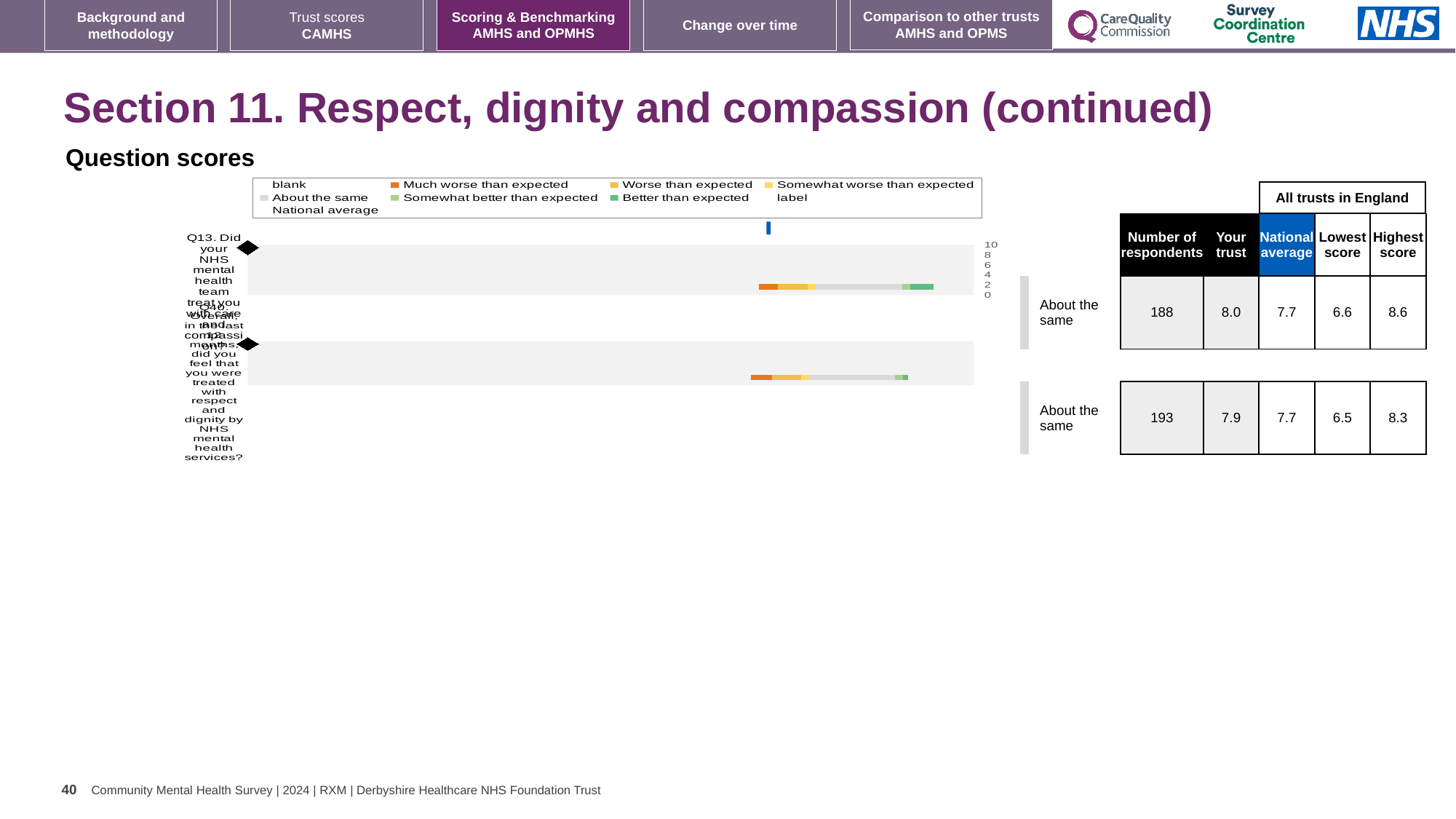
What is the difference between the highest score and the lowest score for Q10 in the table beside the chart? 1.8 In the table beside the chart, what is the lowest score across all trusts in England for Q10? 6.5 In the table beside the chart, what is the 'Your trust' score for Q13? 8.0 What does the blue marker in the chart legend represent? National average In the table beside the chart, what is the number of respondents for Q10? 193 Which legend entry is shown in grey in the chart? About the same In the table beside the chart, what is the 'Your trust' score for Q10? 7.9 In the table beside the chart, what is the number of respondents for Q13? 188 How many questions (categories) are plotted in the chart? 2 For Q13, which is larger: the 'Your trust' score or the national average? Your trust What kind of chart is shown on the slide? bar chart In the table beside the chart, what is the highest score across all trusts in England for Q13? 8.6